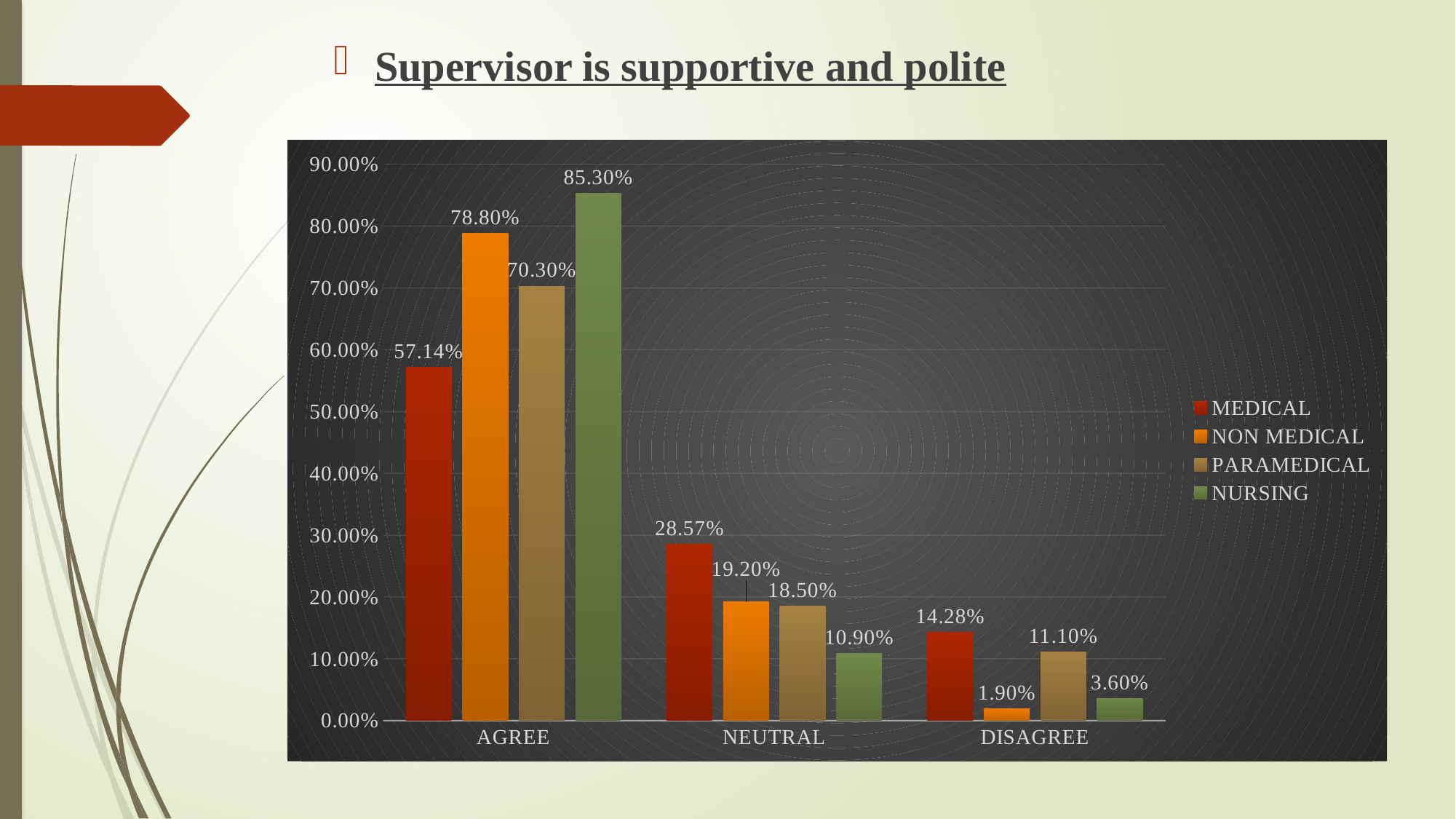
What is the value for MEDICAL in the NEUTRAL category? 28.57% How many series does the legend list? 4 Which series has the highest value in the AGREE category? NURSING What kind of chart is shown on the slide? Bar chart What is the value for NURSING in the AGREE category? 85.30% What is the difference between the NON MEDICAL and MEDICAL values in the AGREE category? 21.66% What is the value for PARAMEDICAL in the AGREE category? 70.30% What is the title of the slide above the chart? Supervisor is supportive and polite What is the value for NON MEDICAL in the DISAGREE category? 1.90% Which is larger: the PARAMEDICAL value for NEUTRAL or the NURSING value for NEUTRAL? PARAMEDICAL How many categories are shown on the x axis? 3 Which series has the lowest value in the DISAGREE category? NON MEDICAL